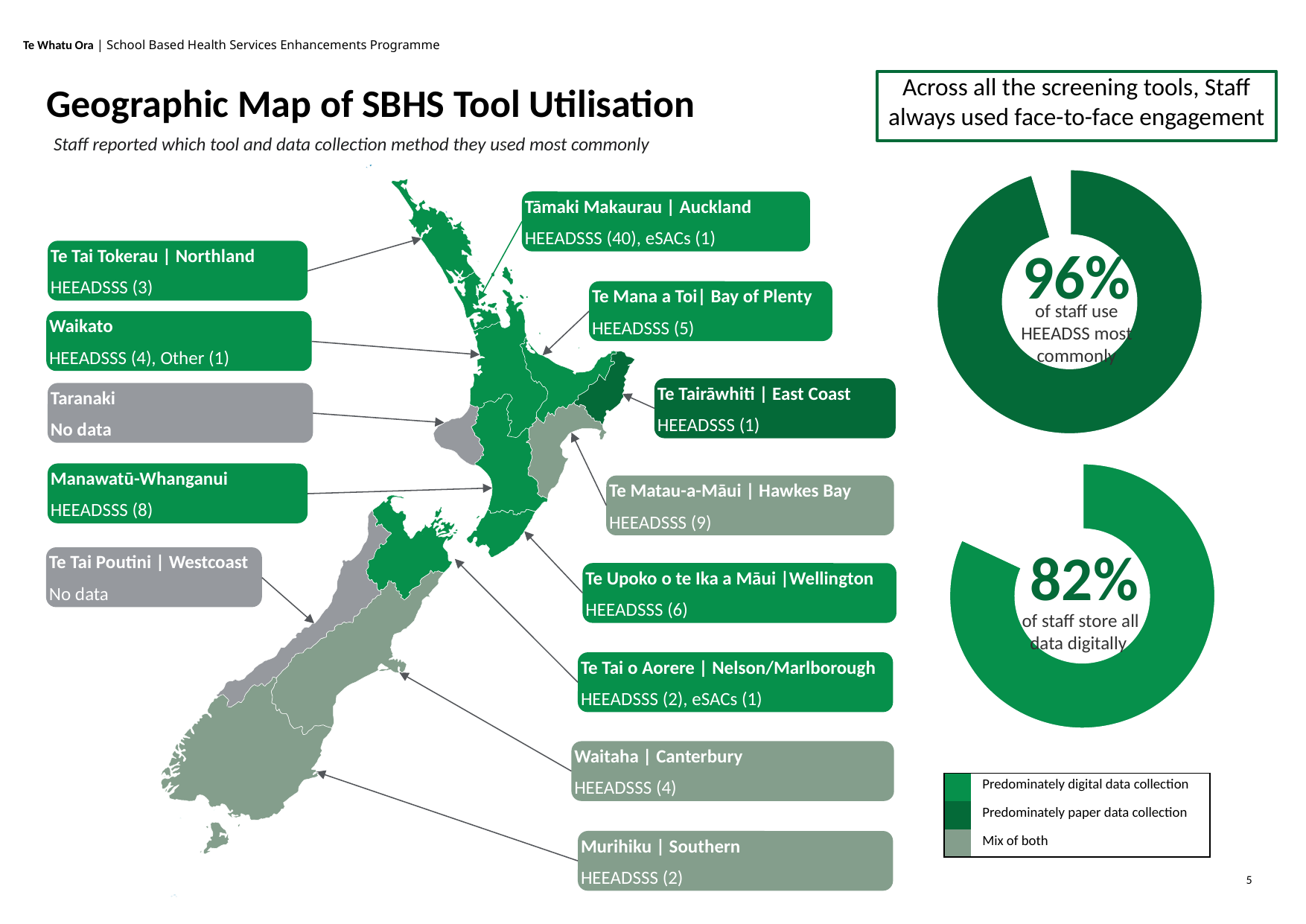
What is the difference between the percentage of staff who use HEEADSS most commonly and the percentage who store all data digitally? 14 percentage points On the map, what is the difference between the HEEADSSS count for Manawatū-Whanganui and for Te Tai Tokerau | Northland? 5 On the upper donut chart, what percentage of staff use HEEADSS most commonly? 96% On the map, how many HEEADSSS uses are reported for Te Matau-a-Māui | Hawkes Bay? 9 On the map, how many HEEADSSS uses are reported for Tāmaki Makaurau | Auckland? 40 How many categories does the map legend list? 3 On the map, which region reports the highest HEEADSSS count? Tāmaki Makaurau | Auckland On the lower donut chart, what percentage of staff store all data digitally? 82% According to the map legend, what does the darkest green colour represent? Predominately paper data collection Which of the two donut charts shows the larger percentage, the one about HEEADSS use or the one about storing data digitally? The one about HEEADSS use (96%) What kind of chart is used to show the 96% figure on the right of the slide? Donut chart On the map, which two regions report no data? Taranaki and Te Tai Poutini | Westcoast